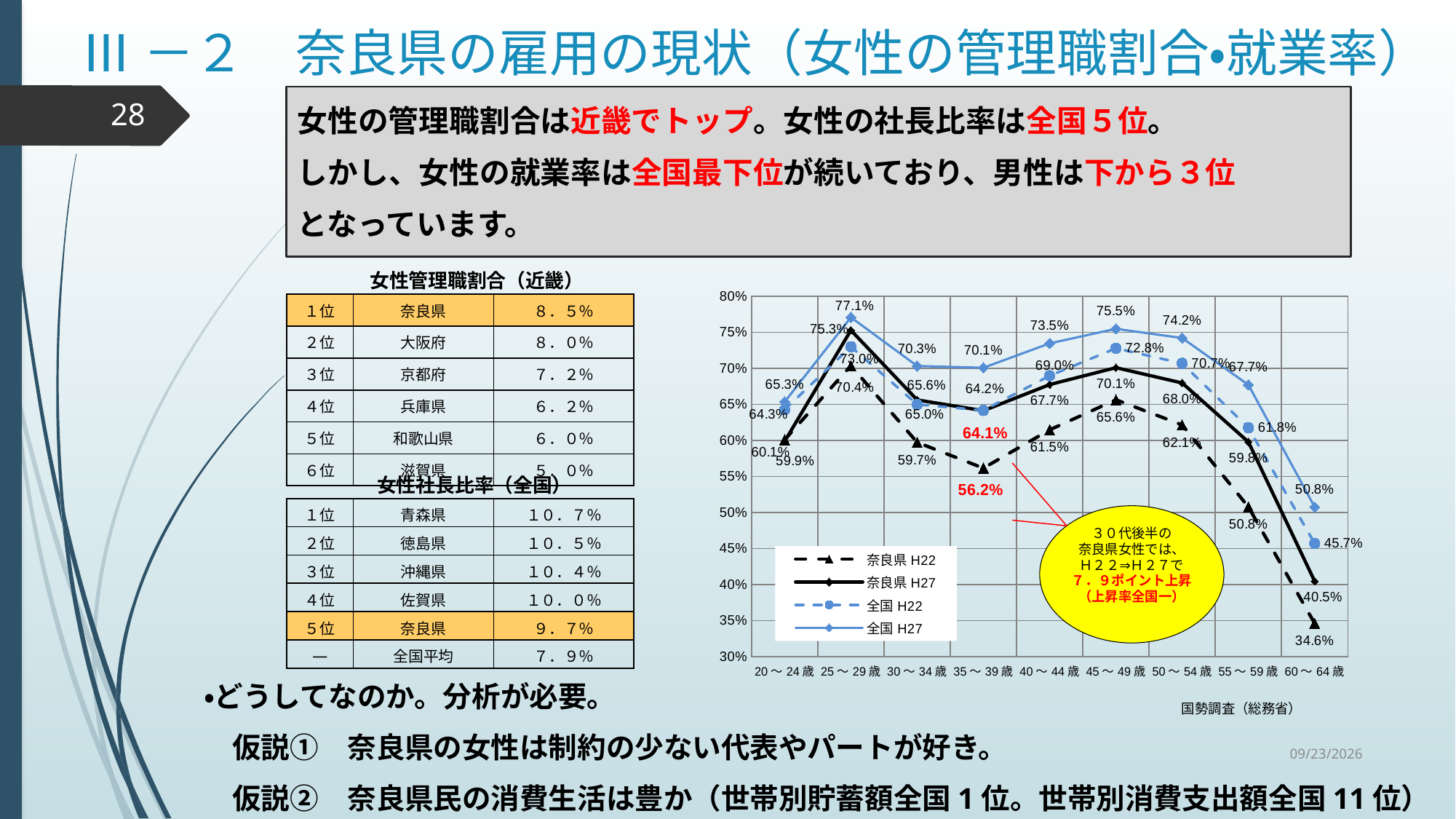
In the line chart, what is the value for 全国 H27 at 60～64歳? 50.8% In the line chart, at which age group does the 全国 H27 series reach its highest value? 25～29歳 How many series does the legend of the line chart list? 4 In the line chart, is the value for 全国 H22 at 60～64歳 greater or less than 50%? less In the line chart, what is the lowest value of the 奈良県 H22 series? 34.6% How many age groups are shown along the x axis of the line chart? 9 In the line chart, does the 全国 H27 series rise or fall from 45～49歳 to 60～64歳? fall In the line chart, at 25～29歳, which is larger: 全国 H27 or 奈良県 H22? 全国 H27 What kind of chart is shown on the right side of the slide? line chart In the line chart, by how many percentage points does 奈良県 H27 exceed 奈良県 H22 at 35～39歳? 7.9 In the line chart, what is the value for 奈良県 H22 at 35～39歳? 56.2% In the line chart, what is the value for 奈良県 H27 at 35～39歳? 64.1%